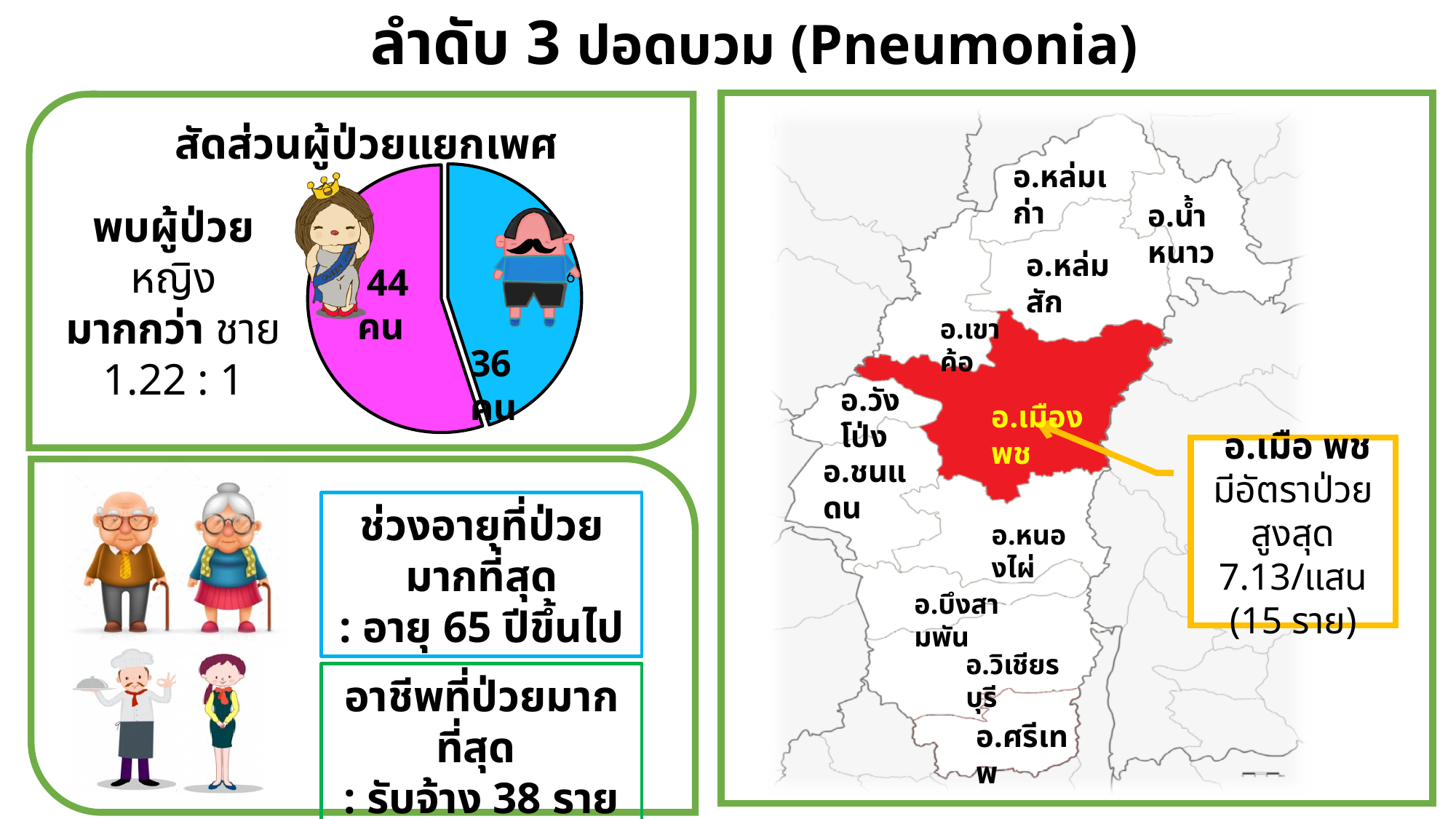
In the pie chart, how many patients are male (ชาย)? 36 คน In the pie chart, how many patients are female (หญิง)? 44 คน What share of the pie chart do female patients represent? 55% What colour is the female slice of the pie chart? pink What share of the pie chart do male patients represent? 45% What is the total number of patients shown in the pie chart? 80 Which slice of the pie chart is smaller, female or male? male (ชาย) What kind of chart is shown in the 'สัดส่วนผู้ป่วยแยกเพศ' panel? pie chart How many slices does the pie chart have? 2 How many more female patients than male patients does the pie chart show? 8 What is the title of the pie chart? สัดส่วนผู้ป่วยแยกเพศ Which slice of the pie chart is larger, female or male? female (หญิง)